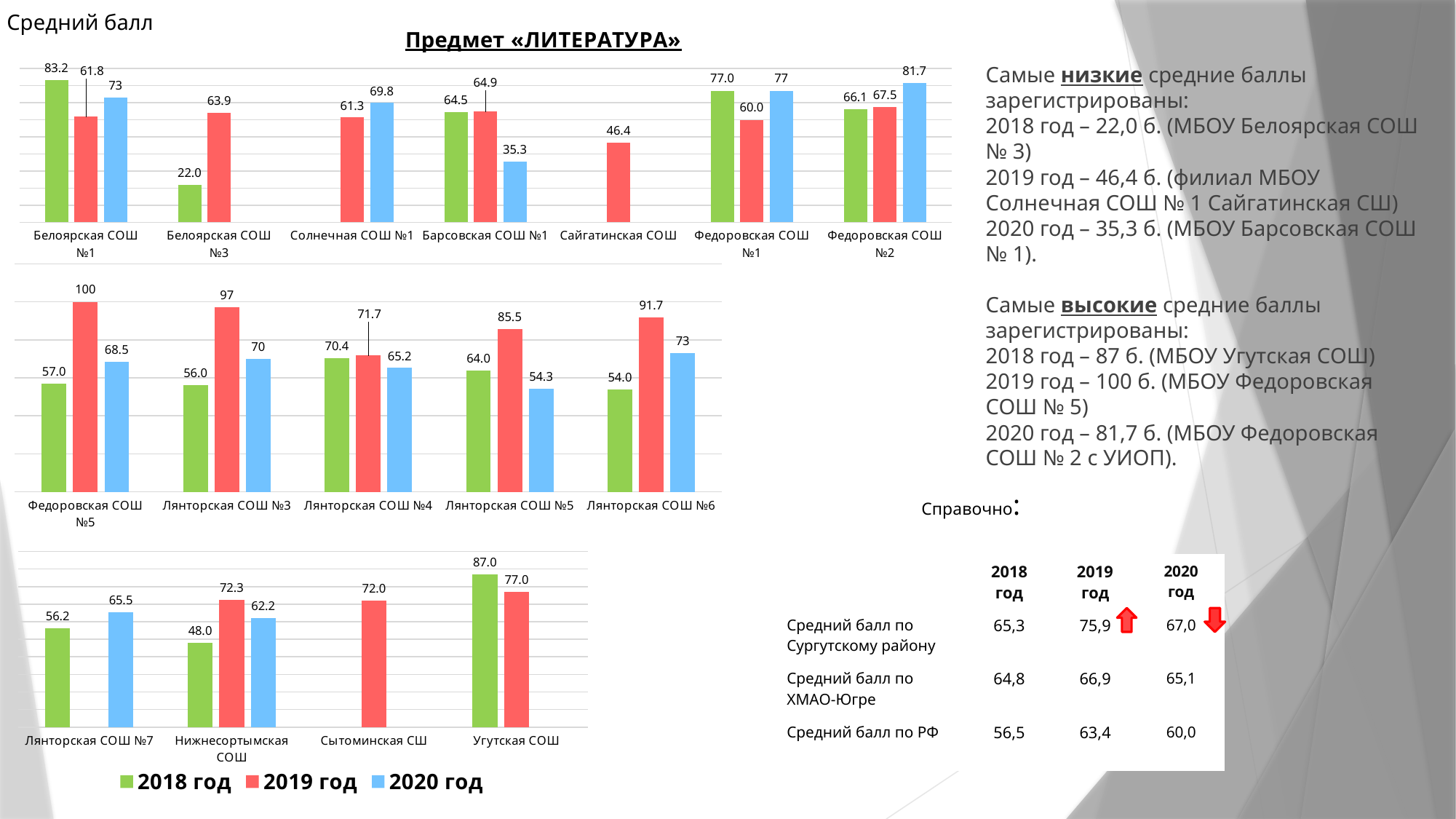
How many series does the legend list? 3 How many schools are shown on the x axis of the middle chart? 5 In the top chart, what is the difference between the 2020 год values for Федоровская СОШ №2 and Барсовская СОШ №1? 46.4 In the top chart, which school has the lowest 2018 год value? Белоярская СОШ №3 In the middle chart, which school has the highest 2019 год value? Федоровская СОШ №5 In the bottom chart, what is the 2020 год value for Нижнесортымская СОШ? 62.2 In the top chart, what is the 2018 год value for Белоярская СОШ №1? 83.2 In the bottom chart, which school has the highest 2018 год value? Угутская СОШ What kind of chart is the bottom chart? Bar chart In the middle chart, which is larger for Лянторская СОШ №6: the 2019 год value or the 2020 год value? 2019 год Which colour represents 2020 год in the legend? Blue In the middle chart, what is the 2019 год value for Федоровская СОШ №5? 100